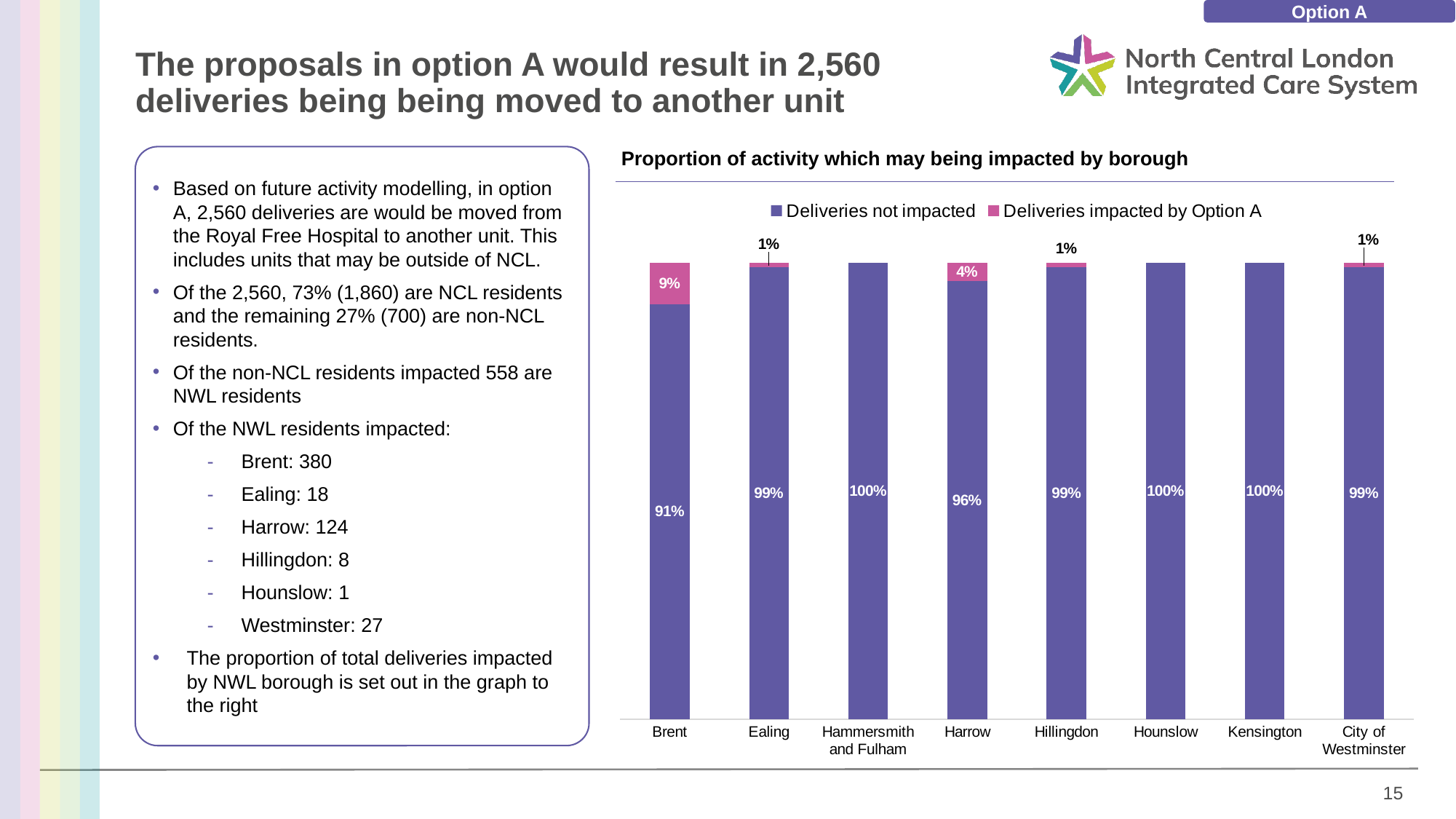
Which has a larger 'Deliveries impacted by Option A' share, Brent or Harrow? Brent What kind of chart is shown on the slide? Stacked bar chart What is the difference between the 'Deliveries not impacted' percentages for Brent and Harrow? 5% Which borough has the lowest proportion of deliveries not impacted? Brent How many series does the chart legend list? 2 Which borough has the highest proportion of deliveries impacted by Option A? Brent What percentage of deliveries are impacted by Option A in Harrow? 4% How many boroughs are shown on the x axis of the chart? 8 What percentage of deliveries are impacted by Option A in Brent? 9% What percentage of deliveries are not impacted in Hammersmith and Fulham? 100% What is the title of the chart? Proportion of activity which may being impacted by borough What percentage of deliveries are not impacted in Brent? 91%